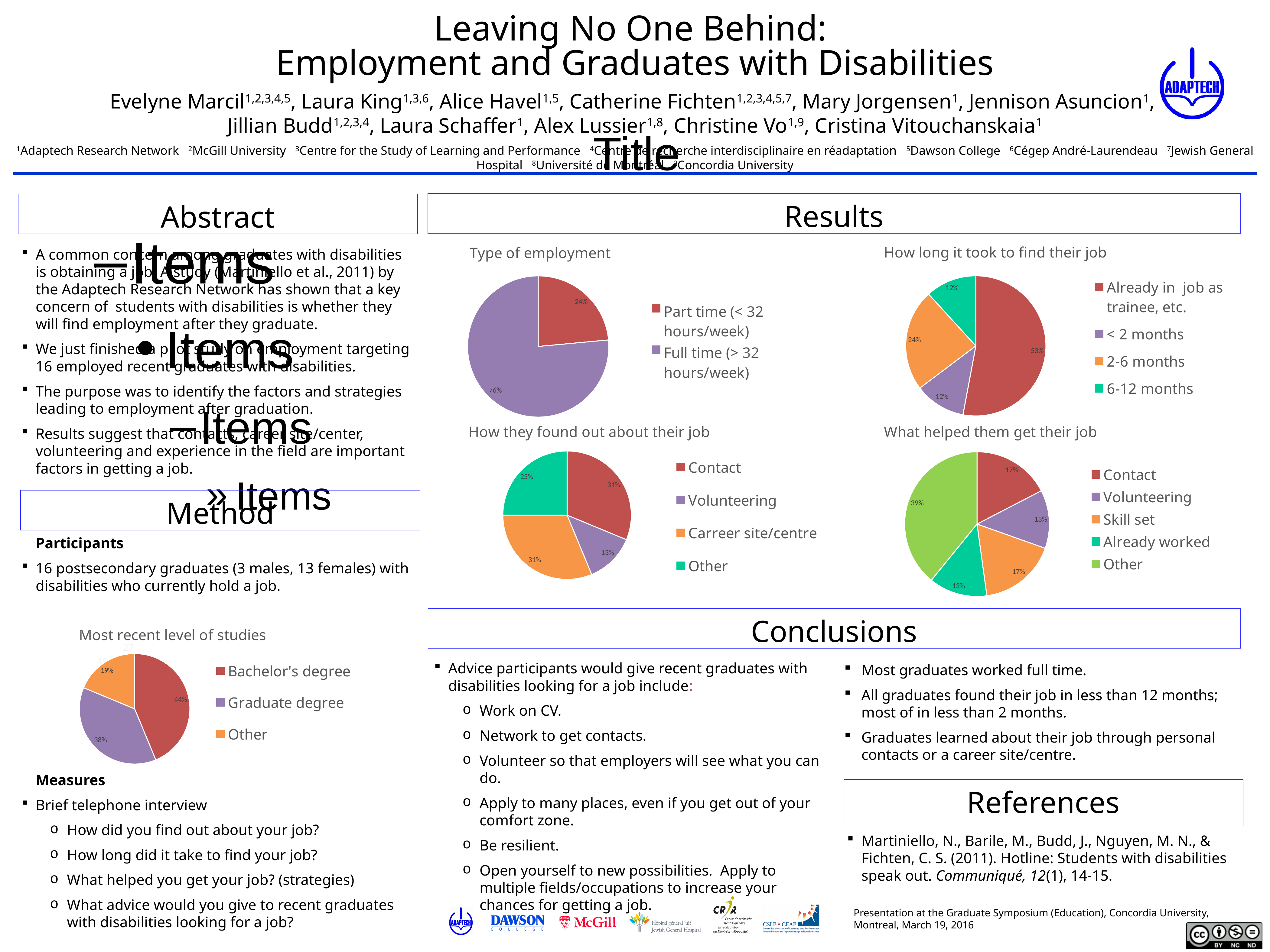
In the 'How long it took to find their job' chart, what share were already in the job as trainee, etc.? 53% In the 'Most recent level of studies' chart, what share of participants had a Graduate degree? 38% In the 'Type of employment' chart, what share of graduates worked part time (< 32 hours/week)? 24% In the 'Type of employment' chart, what share of graduates worked full time (> 32 hours/week)? 76% In the 'What helped them get their job' chart, which is larger: 'Skill set' or 'Already worked'? Skill set In the 'How they found out about their job' chart, what share is 'Other'? 25% In the 'What helped them get their job' chart, what share is 'Other'? 39% In the 'How they found out about their job' chart, which category has the smallest share? Volunteering What kind of chart is 'How long it took to find their job'? Pie chart In the 'How long it took to find their job' chart, what is the difference between the '2-6 months' share and the '6-12 months' share? 12% In the 'How long it took to find their job' chart, which category has the largest share? Already in job as trainee, etc. How many categories does the legend of the 'How they found out about their job' chart list? 4